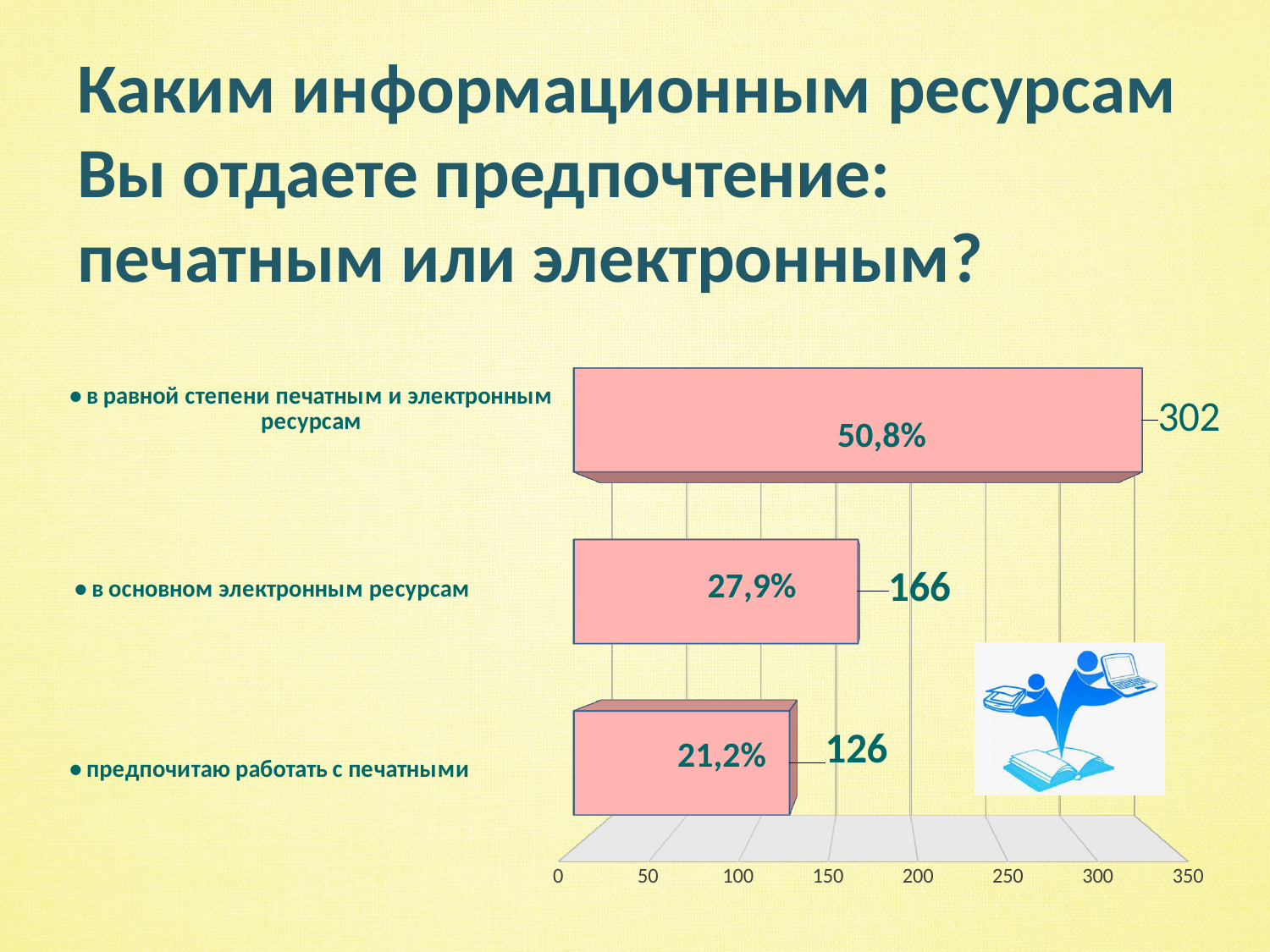
Is the value for "в равной степени печатным и электронным ресурсам" greater or less than 250? greater Which category has the highest value? в равной степени печатным и электронным ресурсам What kind of chart is shown on the slide? bar chart What percentage is shown on the bar for "в основном электронным ресурсам"? 27,9% What is the value for "предпочитаю работать с печатными"? 126 Which category has the lowest value? предпочитаю работать с печатными What is the value for "в основном электронным ресурсам"? 166 What is the difference between the values for "в равной степени печатным и электронным ресурсам" and "в основном электронным ресурсам"? 136 What percentage is shown on the bar for "предпочитаю работать с печатными"? 21,2% Which is larger: the value for "в основном электронным ресурсам" or for "предпочитаю работать с печатными"? в основном электронным ресурсам What is the value for "в равной степени печатным и электронным ресурсам"? 302 How many categories does the chart show? 3